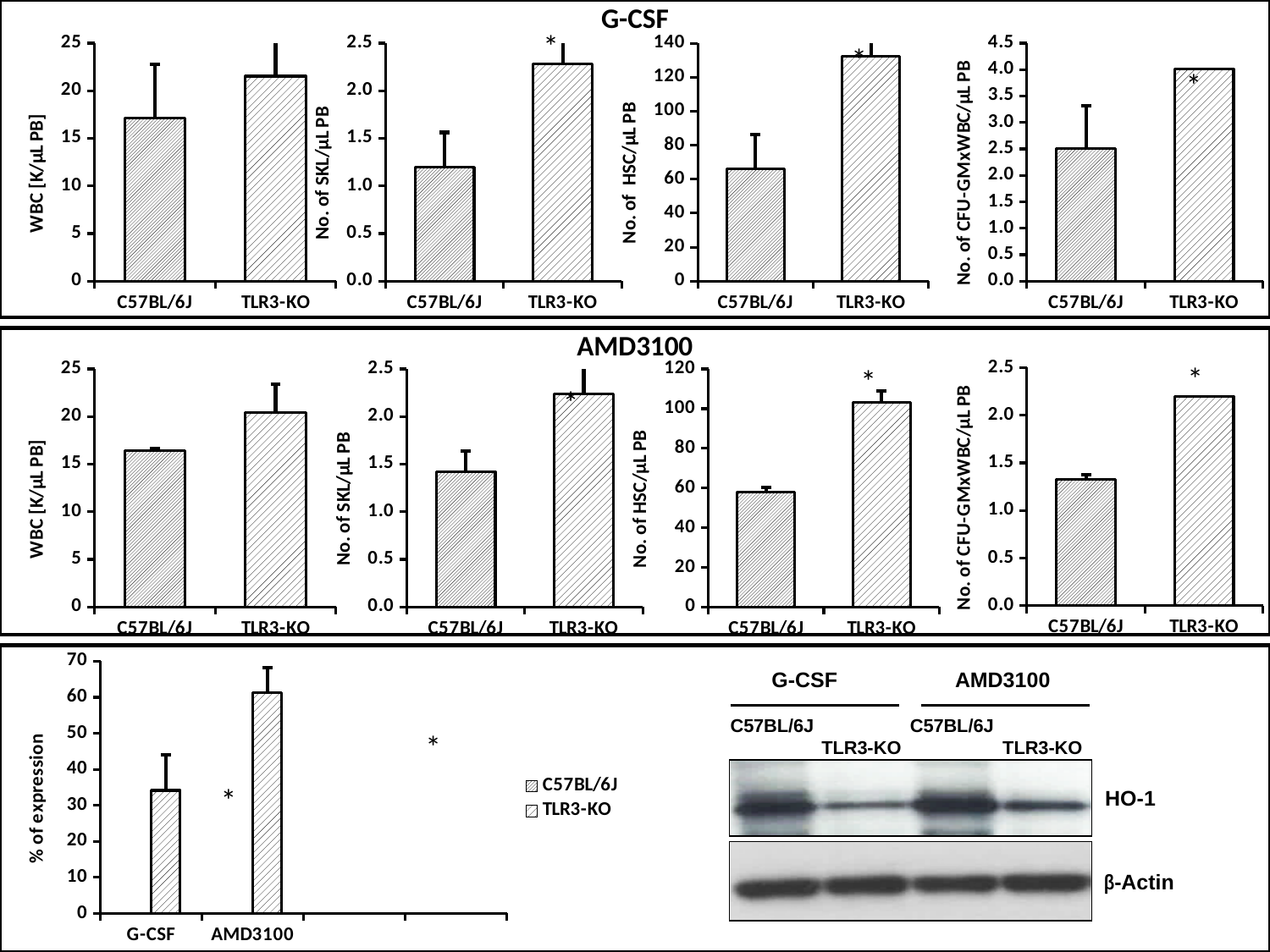
In the AMD3100 row, on the 'No. of HSC/µL PB' chart, is the value for TLR3-KO greater or less than 80? greater What kind of chart is the 'WBC [K/µL PB]' chart in the G-CSF row? bar chart On the bottom-left '% of expression' chart, is the value for AMD3100 greater or less than 50? greater How many series does the legend on the bottom-left '% of expression' chart list? 2 In the G-CSF row, on the 'No. of HSC/µL PB' chart, is the value for C57BL/6J greater or less than 80? less On the bottom-left '% of expression' chart, which category has the higher value, G-CSF or AMD3100? AMD3100 In the G-CSF row, on the 'No. of SKL/µL PB' chart, which category has the higher value, C57BL/6J or TLR3-KO? TLR3-KO In the AMD3100 row, on the 'No. of CFU-GMxWBC/µL PB' chart, which category has the lowest value? C57BL/6J